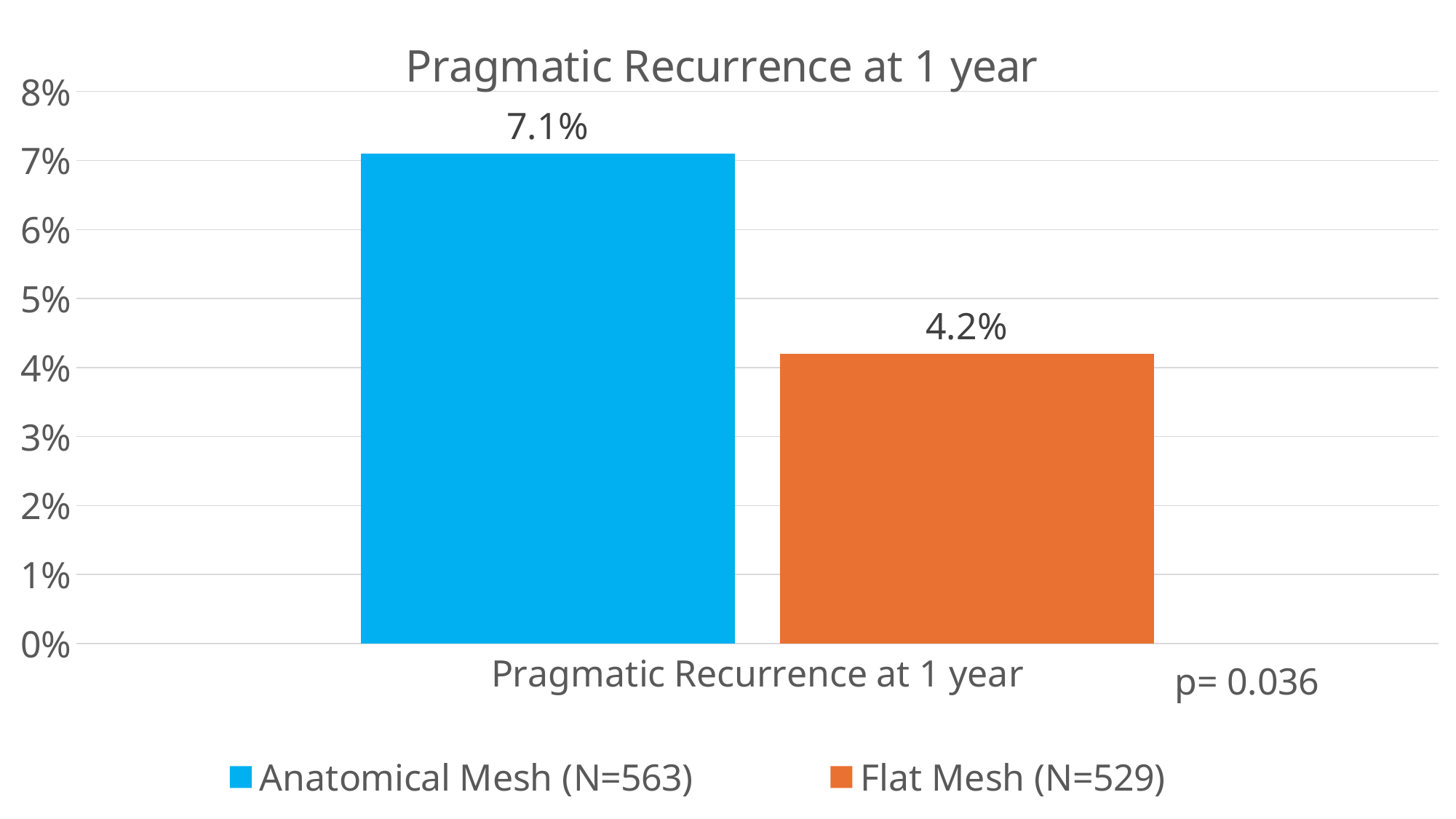
What kind of chart is shown on the slide? bar chart What is the difference in pragmatic recurrence at 1 year between Anatomical Mesh and Flat Mesh? 2.9% Which series has the lower pragmatic recurrence at 1 year? Flat Mesh (N=529) What is the pragmatic recurrence at 1 year for Anatomical Mesh (N=563)? 7.1% Which series has the higher pragmatic recurrence at 1 year? Anatomical Mesh (N=563) What p-value is shown on the slide? p= 0.036 What is the pragmatic recurrence at 1 year for Flat Mesh (N=529)? 4.2% Is the value for Flat Mesh (N=529) greater or less than 5%? less Is the recurrence for Flat Mesh (N=529) larger or smaller than that for Anatomical Mesh (N=563)? smaller How many series does the legend list? 2 Is the value for Anatomical Mesh (N=563) greater or less than 6%? greater What is the title of the chart? Pragmatic Recurrence at 1 year